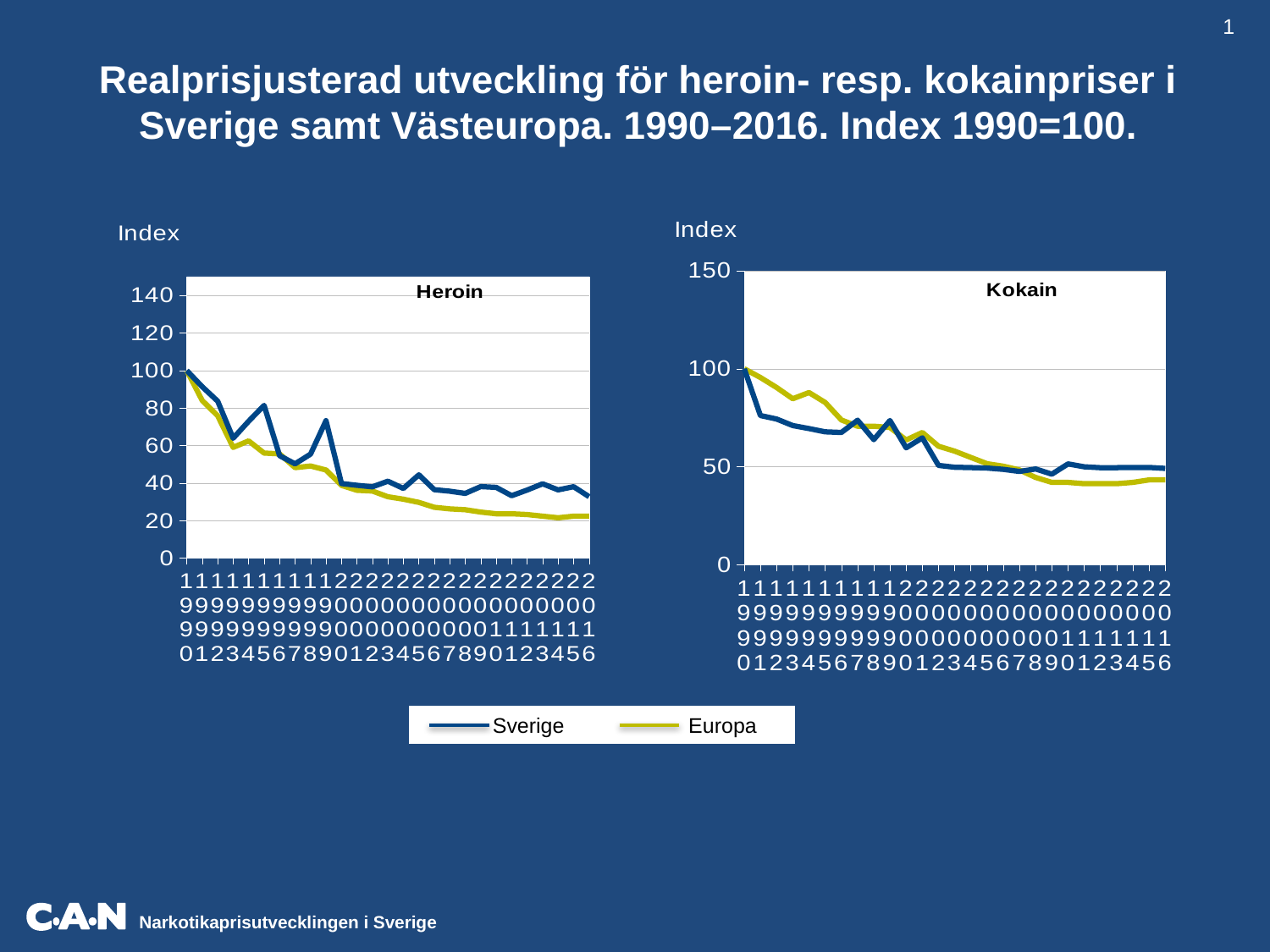
In the Heroin chart, does the Sverige series generally rise or fall from 1990 to 2016? fall In the Kokain chart, which series has the higher value in 1991, Sverige or Europa? Europa In the Heroin chart, is the Europa value for 2016 greater or less than 40? less What is the highest tick value shown on the y axis of the Kokain chart? 150 In the Heroin chart, which series has the higher value in 2016, Sverige or Europa? Sverige In the Heroin chart, in which year does the Sverige series reach its highest value? 1990 In the Kokain chart, is the Sverige value for 2016 greater or less than 100? less What are the two series named in the legend? Sverige and Europa In the Kokain chart, what is the index value for Sverige in 1990? 100 In the Kokain chart, how many years are plotted along the x axis? 27 How many series does the legend list? 2 What kind of chart is the Heroin chart? line chart